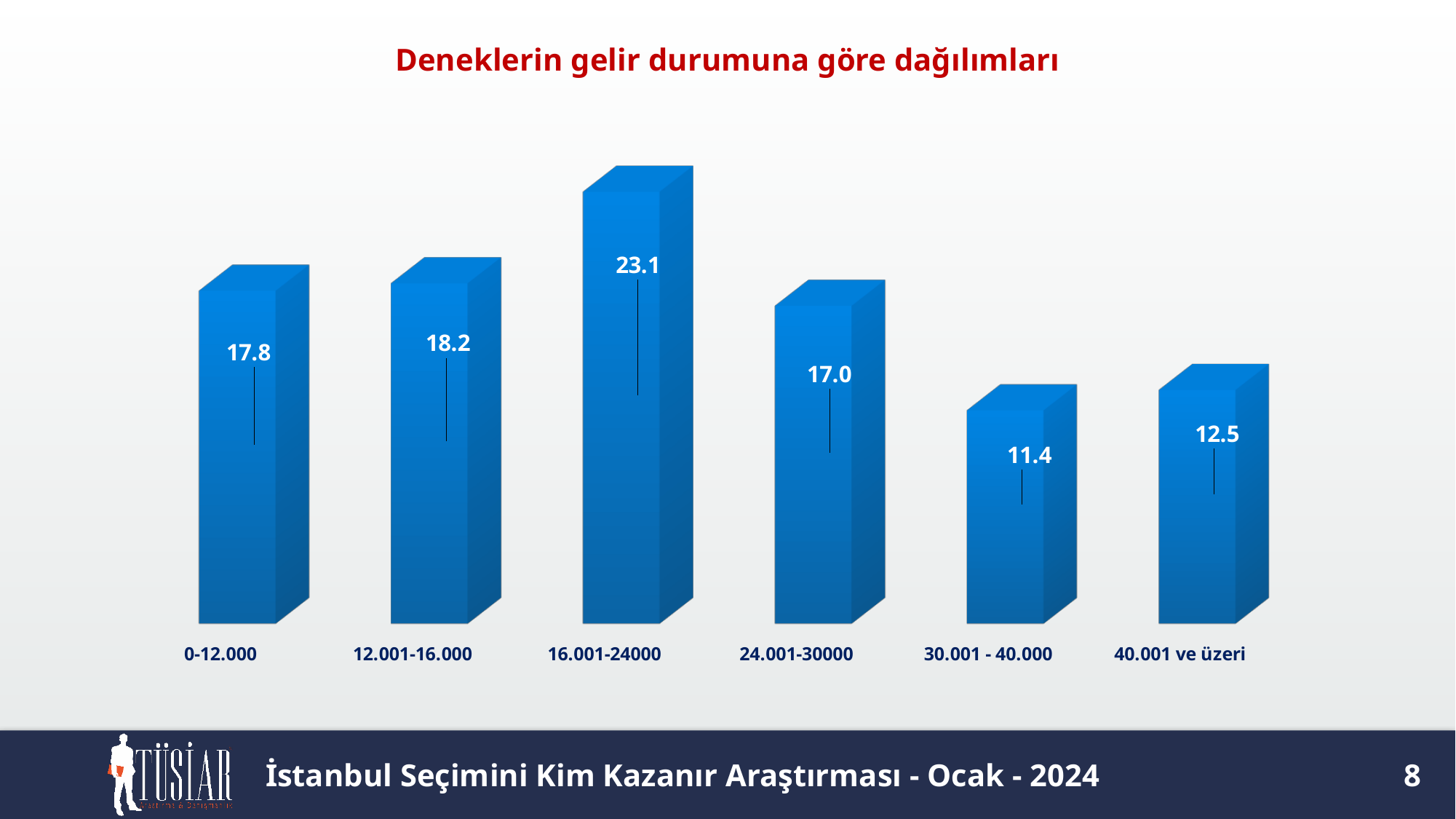
Which income group has the lowest value? 30.001 - 40.000 What is the value for the 30.001 - 40.000 income group? 11.4 Which income group has the highest value? 16.001-24000 What is the difference between the values for 12.001-16.000 and 0-12.000? 0.4 What is the value for the 16.001-24000 income group? 23.1 What is the value for the 40.001 ve üzeri income group? 12.5 What is the value for the 0-12.000 income group? 17.8 What is the difference between the values for 16.001-24000 and 24.001-30000? 6.1 Which is larger, the value for 40.001 ve üzeri or the value for 30.001 - 40.000? 40.001 ve üzeri How many income groups are shown in the chart? 6 What is the title of the chart? Deneklerin gelir durumuna göre dağılımları What kind of chart is shown on the slide? bar chart